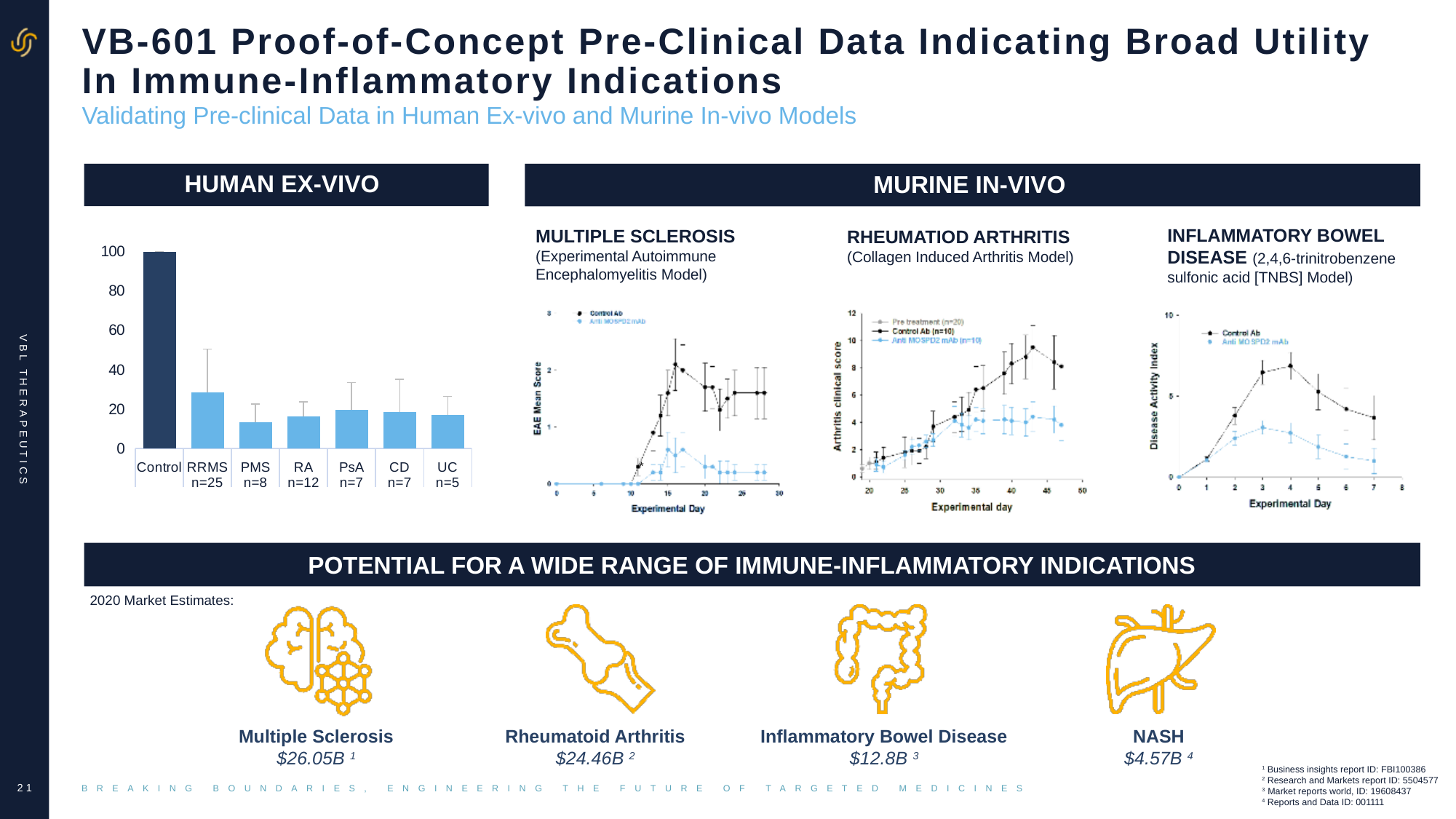
In the Human Ex-Vivo bar chart, is the value for RRMS greater or less than 40? less How many series does the legend of the Rheumatoid Arthritis chart in the Murine In-Vivo section list? 3 In the Human Ex-Vivo bar chart, what is the value for Control? 100 How many categories are shown in the Human Ex-Vivo bar chart? 7 In the Human Ex-Vivo bar chart, is the value for RRMS greater or less than 20? greater What kind of chart is the Human Ex-Vivo chart? bar chart What is the y-axis label of the Inflammatory Bowel Disease chart in the Murine In-Vivo section? Disease Activity Index In the Human Ex-Vivo bar chart, which is larger, the value for RRMS or the value for PMS? RRMS In the Human Ex-Vivo bar chart, which category has the highest value? Control In the Human Ex-Vivo bar chart, is the value for PMS greater or less than 20? less What kind of chart is the Multiple Sclerosis chart in the Murine In-Vivo section? line chart